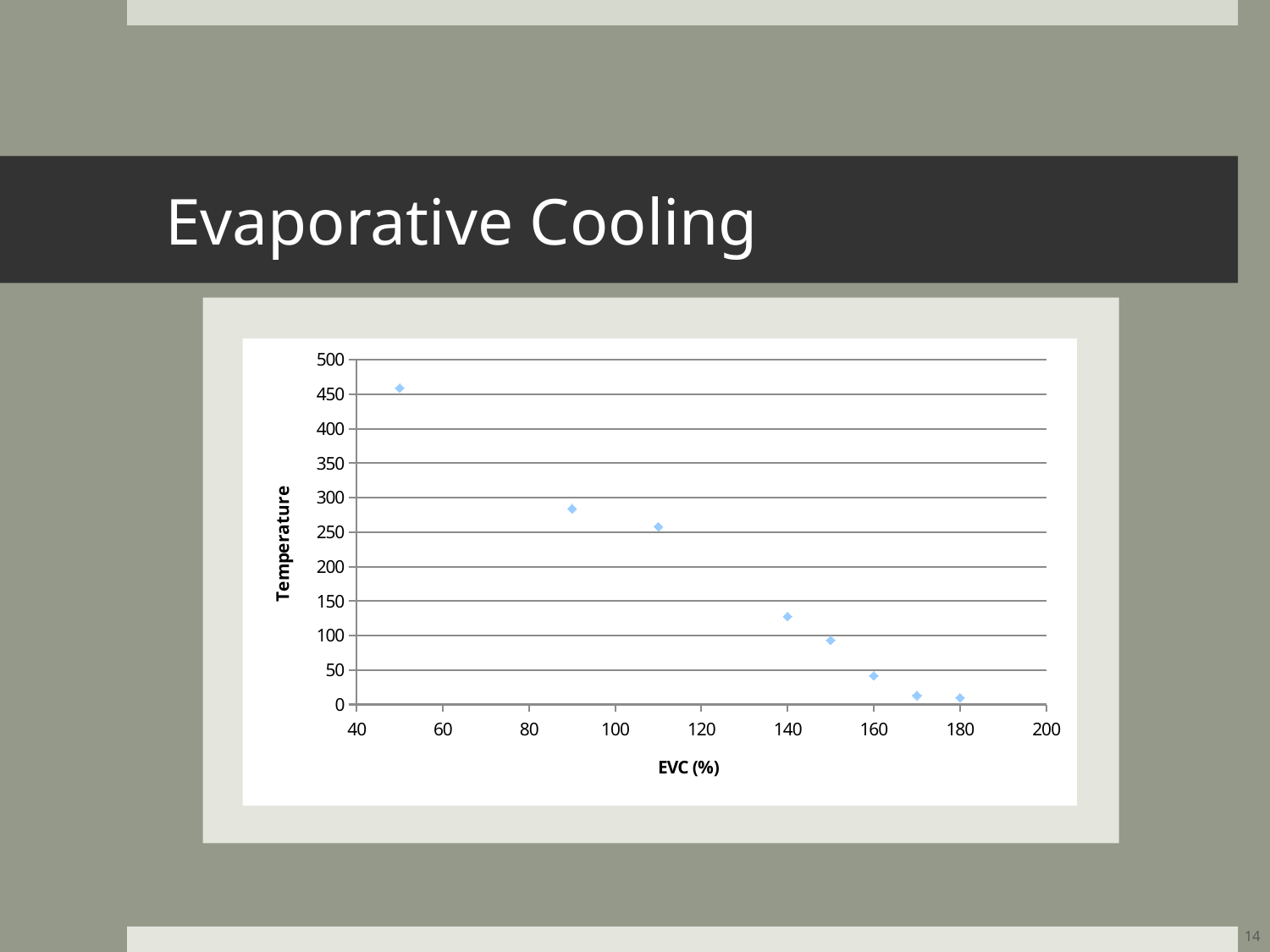
Do the Temperature values rise or fall as EVC (%) increases along the x axis? fall Is the Temperature at EVC 160% greater or less than 50? less Is the Temperature at EVC 90% greater or less than 250? greater Is the Temperature at EVC 50% greater or less than 400? greater What is the title of the y axis? Temperature Which has the higher Temperature, the point at EVC 90% or the point at EVC 140%? EVC 90% What is the title of the x axis? EVC (%) What kind of chart is shown on the slide? scatter chart How many data points are plotted on the chart? 8 At which EVC (%) value is the Temperature highest? 50